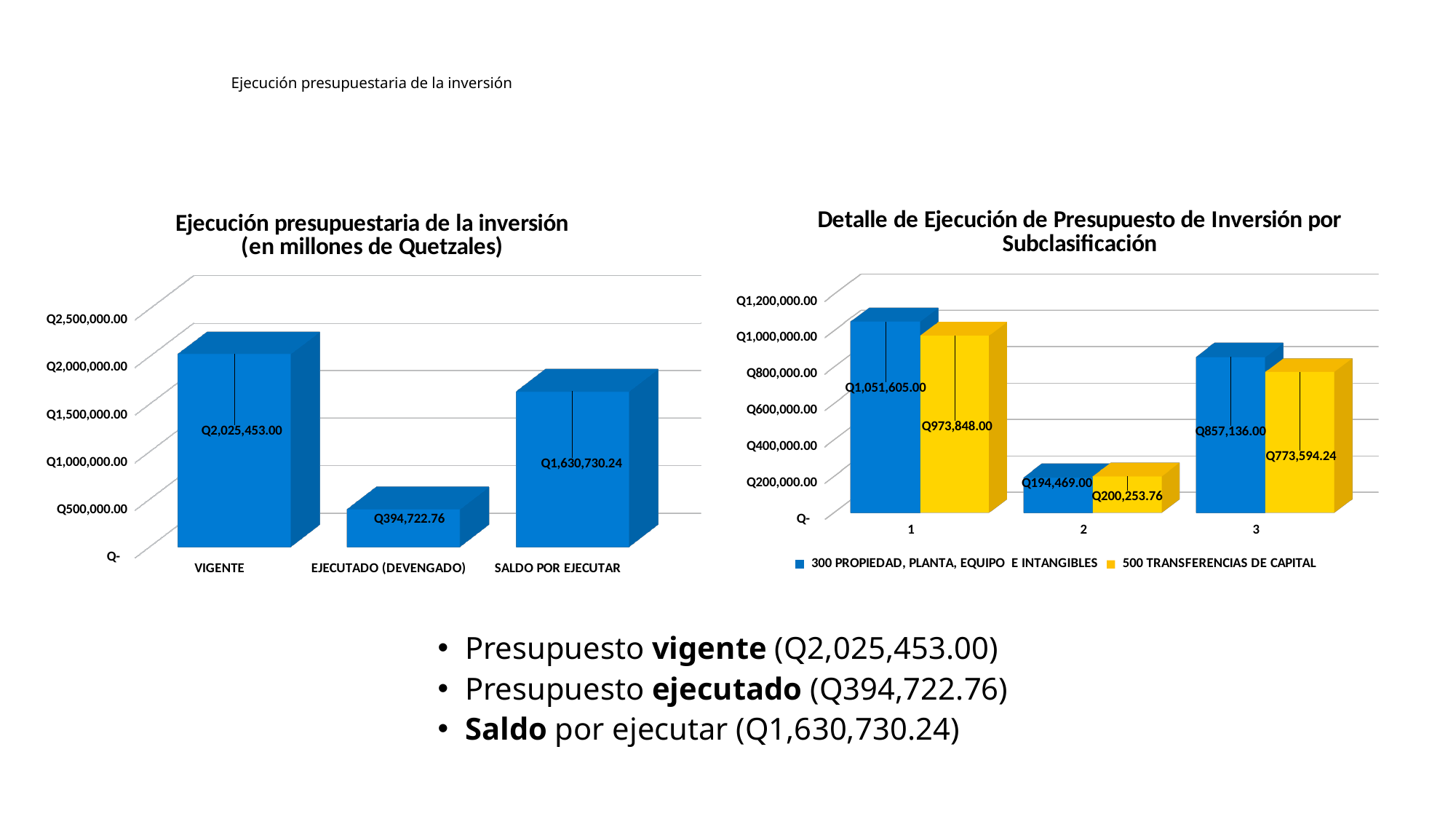
In the chart 'Detalle de Ejecución de Presupuesto de Inversión por Subclasificación', which is larger for category 2: 300 PROPIEDAD, PLANTA, EQUIPO E INTANGIBLES or 500 TRANSFERENCIAS DE CAPITAL? 500 TRANSFERENCIAS DE CAPITAL In the chart 'Detalle de Ejecución de Presupuesto de Inversión por Subclasificación', what is the value of 300 PROPIEDAD, PLANTA, EQUIPO E INTANGIBLES for category 1? Q1,051,605.00 In the chart 'Detalle de Ejecución de Presupuesto de Inversión por Subclasificación', what is the difference between the two series for category 1? Q77,757.00 In the chart 'Ejecución presupuestaria de la inversión (en millones de Quetzales)', what is the value for VIGENTE? Q2,025,453.00 In the chart 'Detalle de Ejecución de Presupuesto de Inversión por Subclasificación', how many series does the legend list? 2 In the chart 'Detalle de Ejecución de Presupuesto de Inversión por Subclasificación', what is the value of 500 TRANSFERENCIAS DE CAPITAL for category 3? Q773,594.24 In the chart 'Ejecución presupuestaria de la inversión (en millones de Quetzales)', what is the difference between VIGENTE and EJECUTADO (DEVENGADO)? Q1,630,730.24 What kind of chart is 'Ejecución presupuestaria de la inversión (en millones de Quetzales)'? Bar chart In the chart 'Ejecución presupuestaria de la inversión (en millones de Quetzales)', how many categories are shown? 3 In the chart 'Detalle de Ejecución de Presupuesto de Inversión por Subclasificación', which colour represents 500 TRANSFERENCIAS DE CAPITAL? Yellow In the chart 'Ejecución presupuestaria de la inversión (en millones de Quetzales)', which category has the lowest value? EJECUTADO (DEVENGADO) In the chart 'Ejecución presupuestaria de la inversión (en millones de Quetzales)', what is the value for EJECUTADO (DEVENGADO)? Q394,722.76